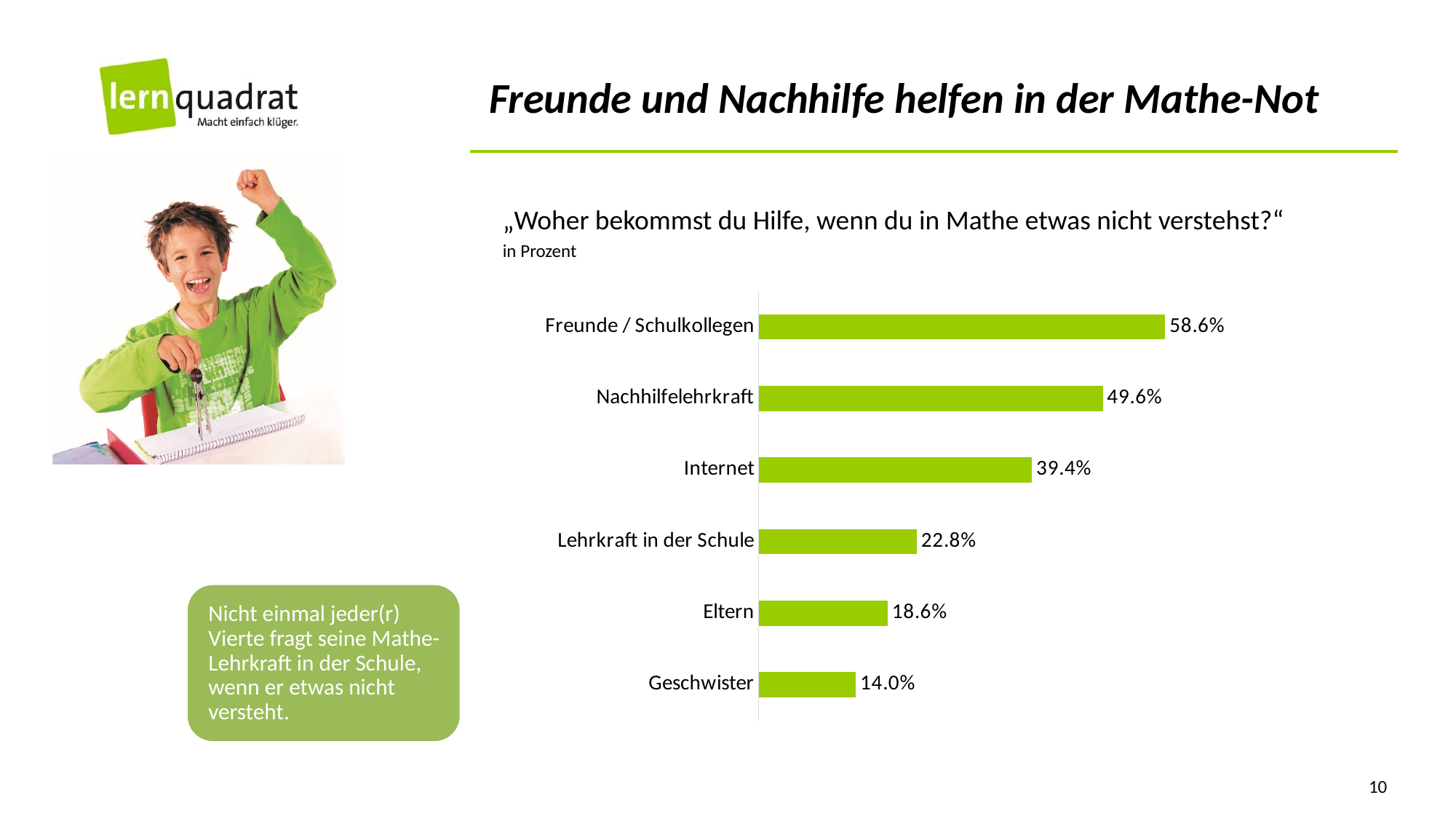
What is the difference between the values for Eltern and Geschwister? 4.6% What is the value for Geschwister? 14.0% Which is larger, the value for Internet or the value for Lehrkraft in der Schule? Internet Which category has the lowest value? Geschwister What is the value for Internet? 39.4% Which category has the highest value? Freunde / Schulkollegen How many categories are shown in the chart? 6 What is the value for Nachhilfelehrkraft? 49.6% What is the value for Lehrkraft in der Schule? 22.8% What is the value for Freunde / Schulkollegen? 58.6% What is the difference between the values for Freunde / Schulkollegen and Nachhilfelehrkraft? 9.0% What kind of chart is shown on the slide? Bar chart